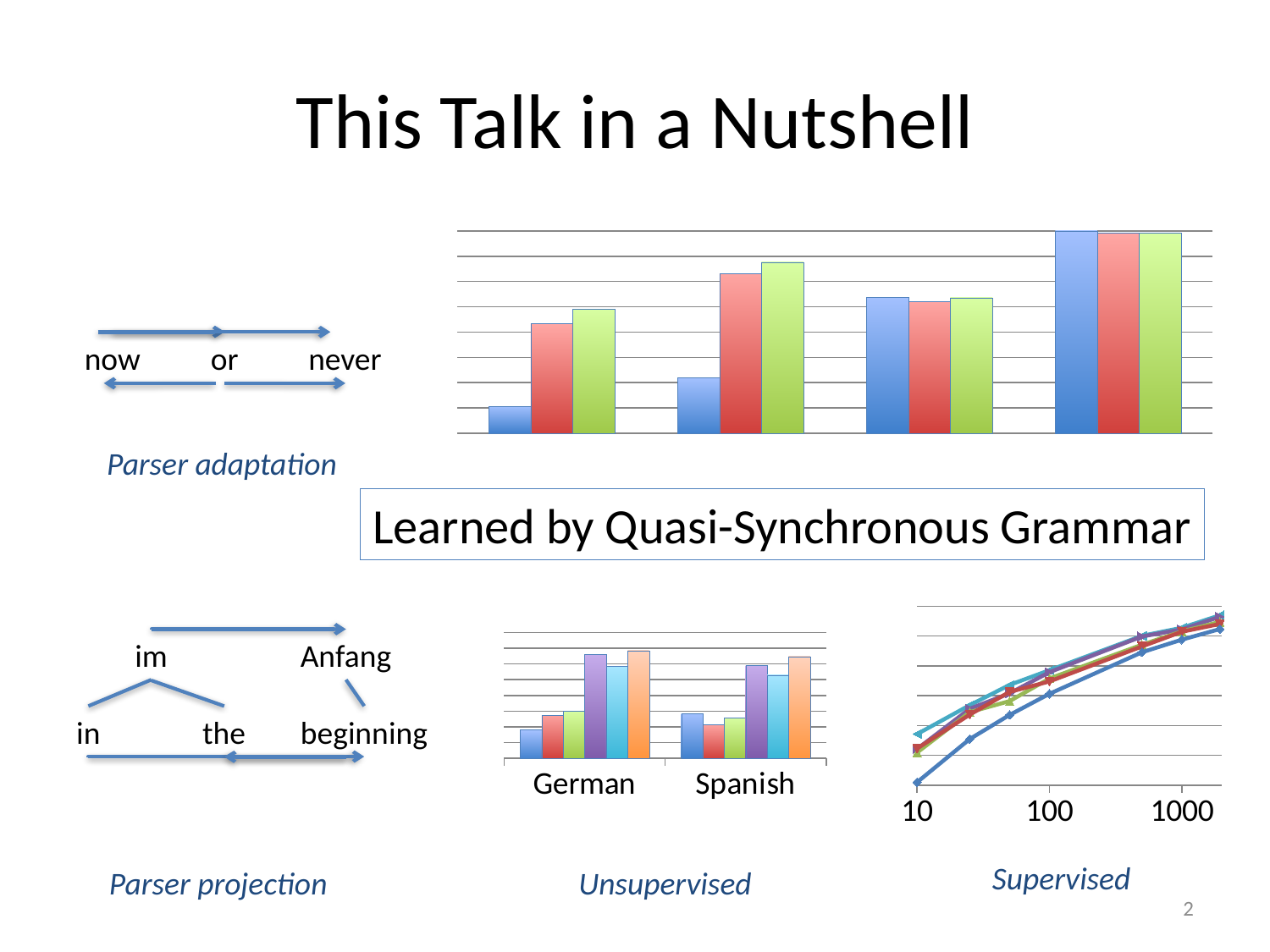
In the top-right bar chart, which bar is the lowest in the leftmost group: the blue, red or green bar? blue What kind of chart is the chart labelled 'Supervised' at the bottom right of the slide? line chart In the top-right bar chart, how many bars are there in each group? 3 In the top-right bar chart, do the blue bars rise or fall from the leftmost group to the rightmost group? rise In the top-right bar chart, how many groups of bars are there? 4 In the 'Unsupervised' bar chart at the bottom middle, what are the two category labels on the x axis? German and Spanish In the 'Unsupervised' bar chart at the bottom middle, how many categories are shown on the x axis? 2 What kind of chart is the chart at the top right of the slide, next to 'Parser adaptation'? bar chart In the 'Supervised' line chart at the bottom right, what tick labels are shown on the x axis? 10, 100, 1000 What kind of chart is the chart labelled 'Unsupervised' at the bottom middle of the slide? bar chart In the 'Supervised' line chart at the bottom right, do the lines rise or fall as the x axis goes from 10 to 1000? rise